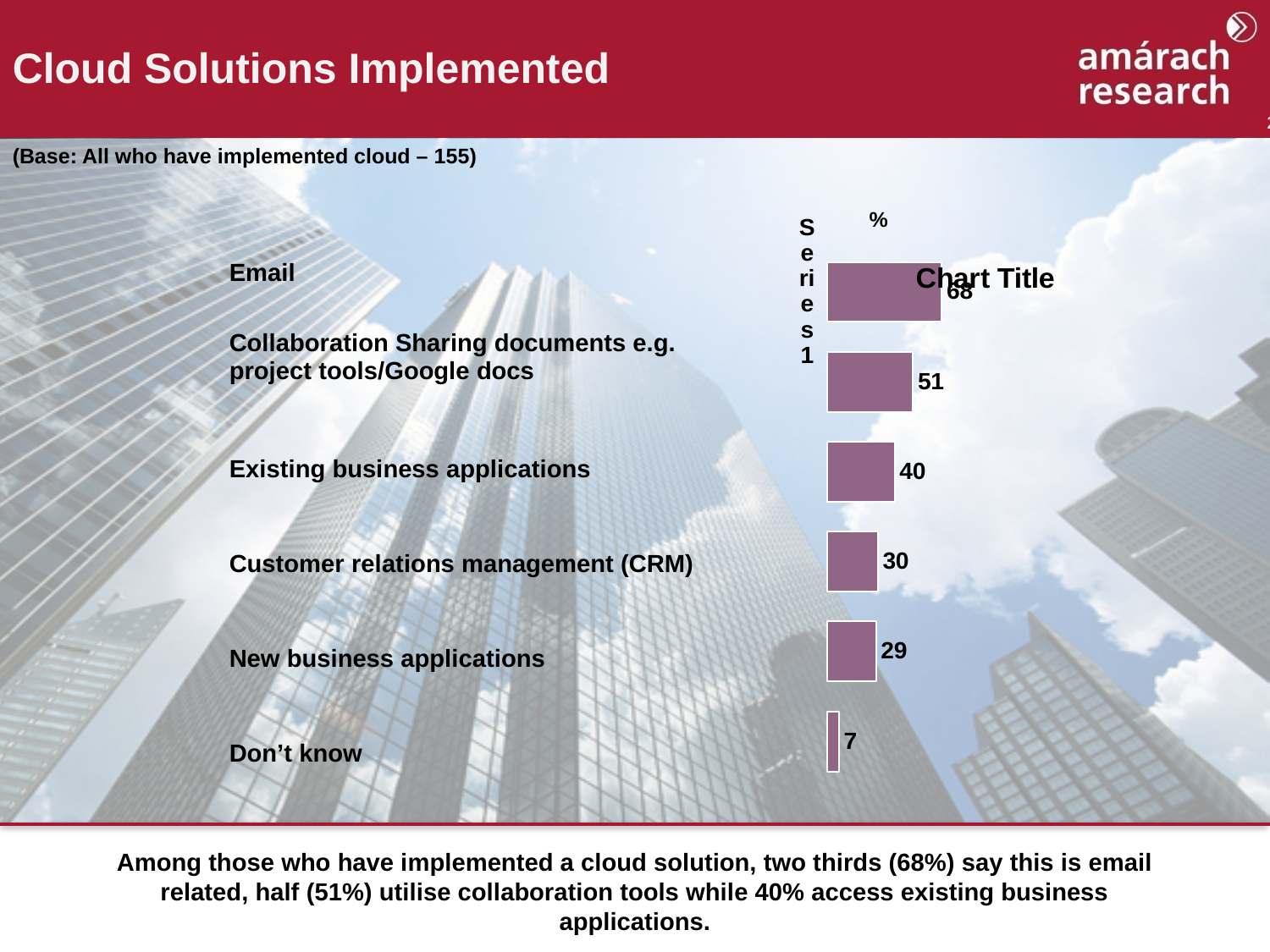
What kind of chart is shown on the slide? Bar chart What is the difference between the values for Email and Collaboration Sharing documents e.g. project tools/Google docs? 17 What is the difference between the values for Existing business applications and New business applications? 11 Which category has the lowest value? Don't know How many categories are shown in the chart? 6 Which is larger, the value for Customer relations management (CRM) or the value for Existing business applications? Existing business applications What is the base size stated on the slide? 155 What is the value for Don't know? 7 Which category has the highest value? Email What is the value for Existing business applications? 40 What is the value for Customer relations management (CRM)? 30 What is the value for Email? 68